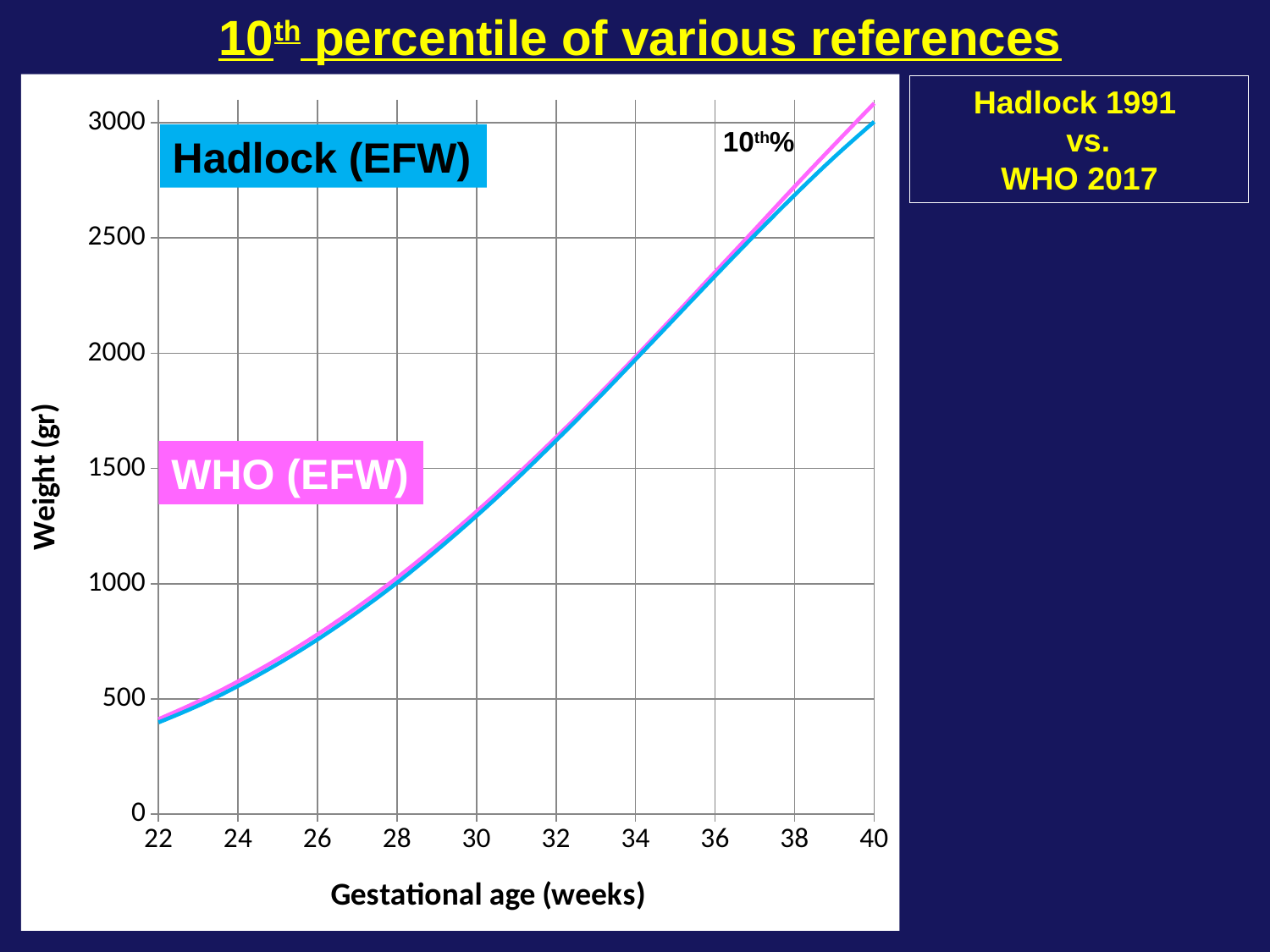
Is the WHO (EFW) value at 36 weeks greater or less than 2500? less Is the WHO (EFW) value at 30 weeks greater or less than 1500? less Which colour is used for the WHO (EFW) line? pink How many series are plotted on the chart? 2 Is the Hadlock (EFW) value at 30 weeks greater or less than 1000? greater What kind of chart is shown on the slide? line chart Do the plotted weights rise or fall as gestational age increases from 22 to 40 weeks? rise What is the title of the chart's x axis? Gestational age (weeks)